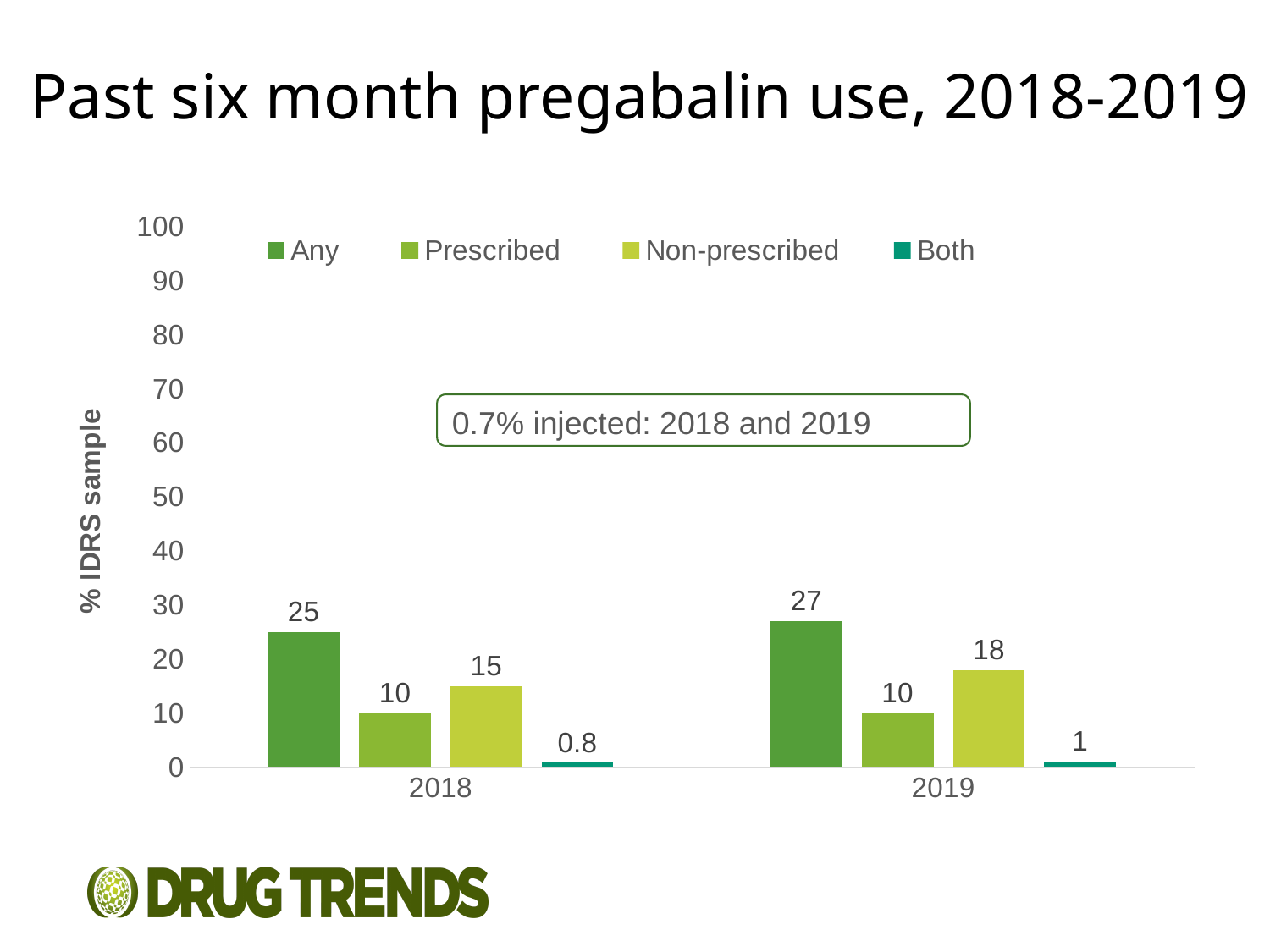
Which is larger, Non-prescribed use in 2018 or Non-prescribed use in 2019? Non-prescribed use in 2019 What is the value for Prescribed pregabalin use in 2019? 10 What is the difference between Non-prescribed and Prescribed use in 2018? 5 What is the value for Non-prescribed pregabalin use in 2019? 18 What is the value for Any pregabalin use in 2018? 25 What is the difference between the Any values for 2019 and 2018? 2 Which series has the highest value in 2019? Any How many series does the legend list? 4 What kind of chart is shown on the slide? Bar chart What is the label on the vertical axis? % IDRS sample Which series has the lowest value in 2018? Both What is the value for Both in 2018? 0.8